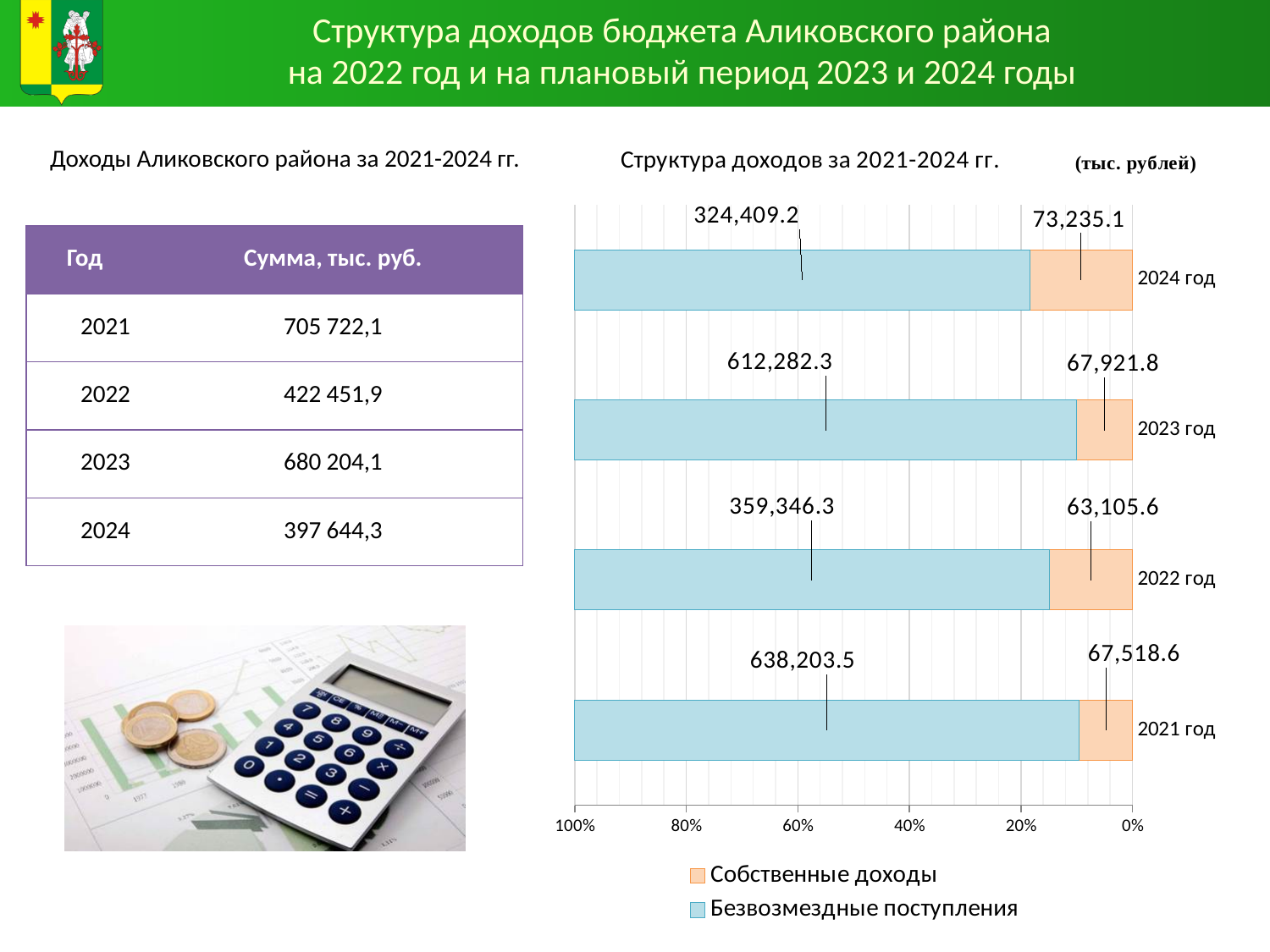
What is the difference between Собственные доходы in 2024 год and in 2021 год? 5,716.5 What is the value of Безвозмездные поступления for 2024 год? 324,409.2 Which year has the highest value of Безвозмездные поступления? 2021 год Which is larger: Безвозмездные поступления in 2023 год or in 2022 год? 2023 год Which year has the lowest value of Собственные доходы? 2022 год Which colour represents Собственные доходы in the chart? Orange What is the value of Собственные доходы for 2022 год? 63,105.6 What kind of chart is shown? Stacked bar chart How many years are shown in the chart? 4 What is the total of the stacked bar for 2024 год? 397,644.3 What is the value of Собственные доходы for 2023 год? 67,921.8 How many series does the legend list? 2